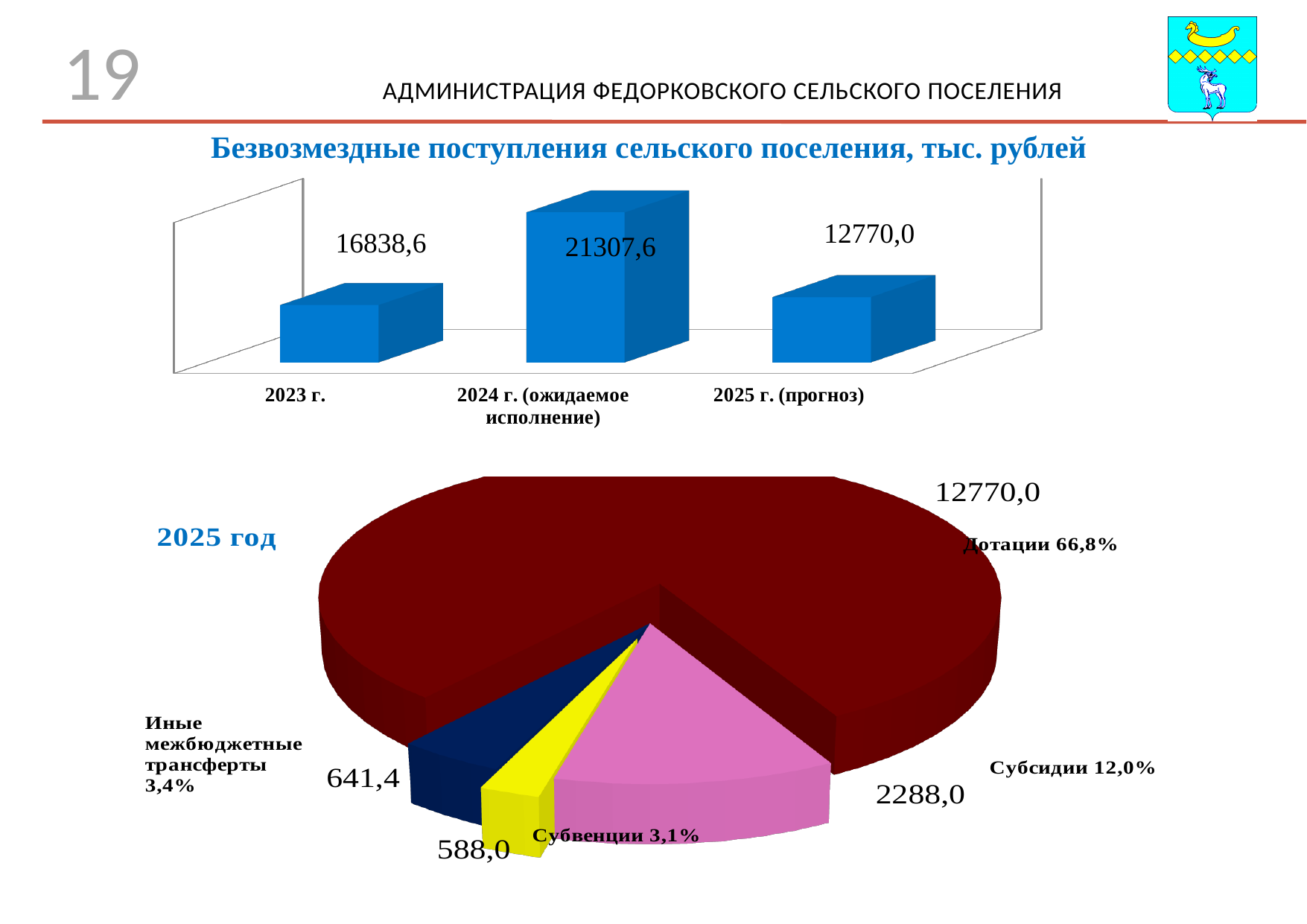
What kind of chart is the upper chart on the slide? Bar chart In the pie chart '2025 год', what is the value for Субсидии? 2288,0 In the bar chart 'Безвозмездные поступления сельского поселения, тыс. рублей', how many bars are shown? 3 In the pie chart '2025 год', which is larger: Иные межбюджетные трансферты or Субвенции? Иные межбюджетные трансферты In the bar chart 'Безвозмездные поступления сельского поселения, тыс. рублей', which year has the highest value? 2024 г. (ожидаемое исполнение) In the pie chart '2025 год', what is the difference between the Субсидии value and the Субвенции value? 1700,0 In the bar chart 'Безвозмездные поступления сельского поселения, тыс. рублей', which year has the lowest value? 2025 г. (прогноз) In the bar chart 'Безвозмездные поступления сельского поселения, тыс. рублей', what is the difference between the 2024 г. (ожидаемое исполнение) value and the 2023 г. value? 4469,0 In the pie chart '2025 год', what percentage share is shown for Дотации? 66,8% In the pie chart '2025 год', which category has the largest slice? Дотации In the bar chart 'Безвозмездные поступления сельского поселения, тыс. рублей', what is the value for 2024 г. (ожидаемое исполнение)? 21307,6 In the bar chart 'Безвозмездные поступления сельского поселения, тыс. рублей', what is the value for 2023 г.? 16838,6